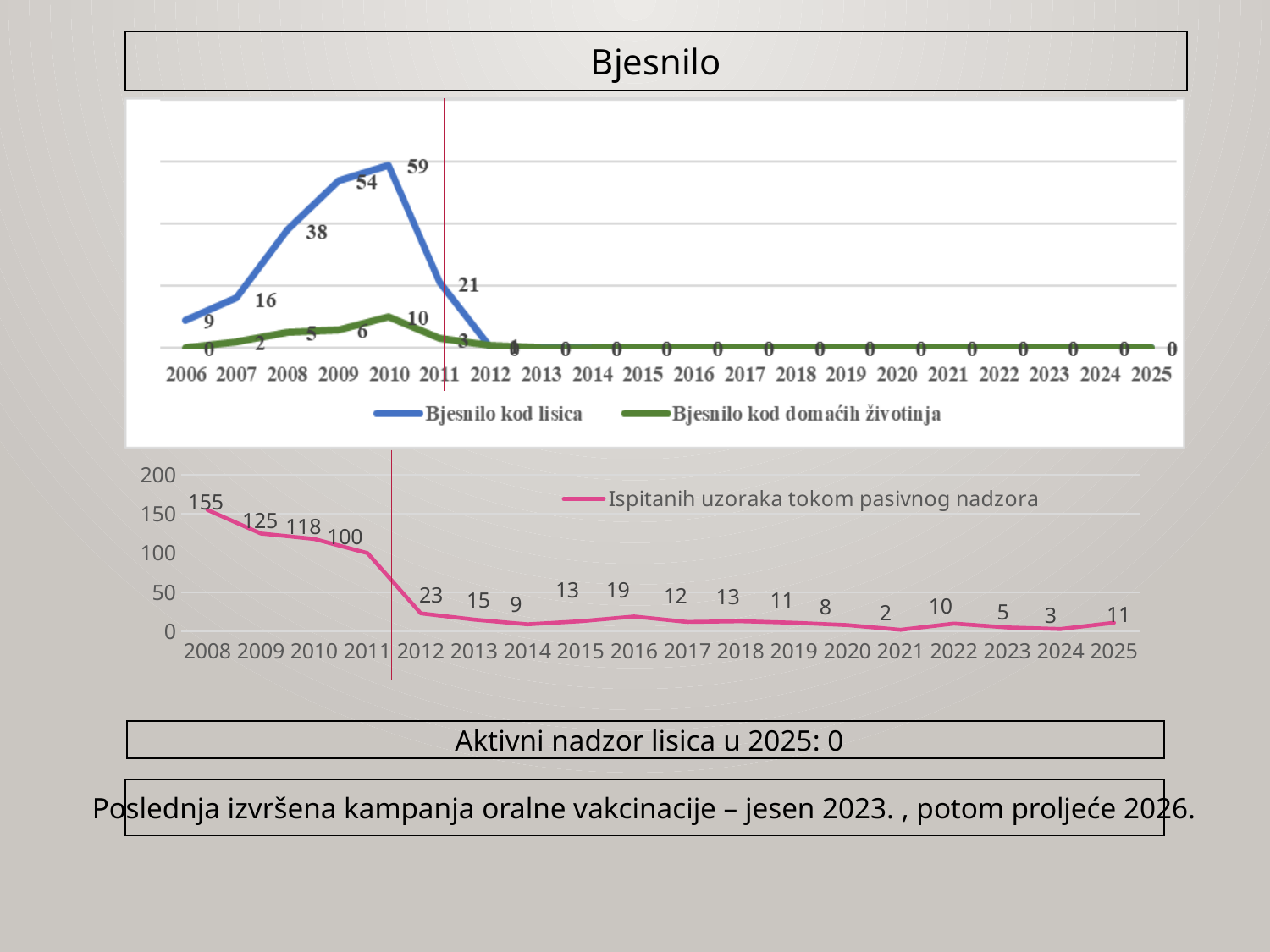
In the bottom chart (Ispitanih uzoraka tokom pasivnog nadzora), what is the value for 2008? 155 In the top chart (Bjesnilo), how many series does the legend list? 2 In the bottom chart (Ispitanih uzoraka tokom pasivnog nadzora), how many years are shown on the x axis? 18 In the top chart (Bjesnilo), what is the difference between Bjesnilo kod lisica in 2009 and in 2011? 33 In the bottom chart (Ispitanih uzoraka tokom pasivnog nadzora), what is the difference between the values for 2011 and 2012? 77 In the top chart (Bjesnilo), what type of chart is shown? Line chart In the bottom chart (Ispitanih uzoraka tokom pasivnog nadzora), do the values rise or fall from 2008 to 2011? Fall In the top chart (Bjesnilo), what is the value for Bjesnilo kod lisica in 2010? 59 In the top chart (Bjesnilo), what is the value for Bjesnilo kod domaćih životinja in 2010? 10 In the top chart (Bjesnilo), which year has the highest value for Bjesnilo kod lisica? 2010 In the bottom chart (Ispitanih uzoraka tokom pasivnog nadzora), which year has the lowest value? 2021 In the bottom chart (Ispitanih uzoraka tokom pasivnog nadzora), which is larger, the value for 2016 or the value for 2025? 2016